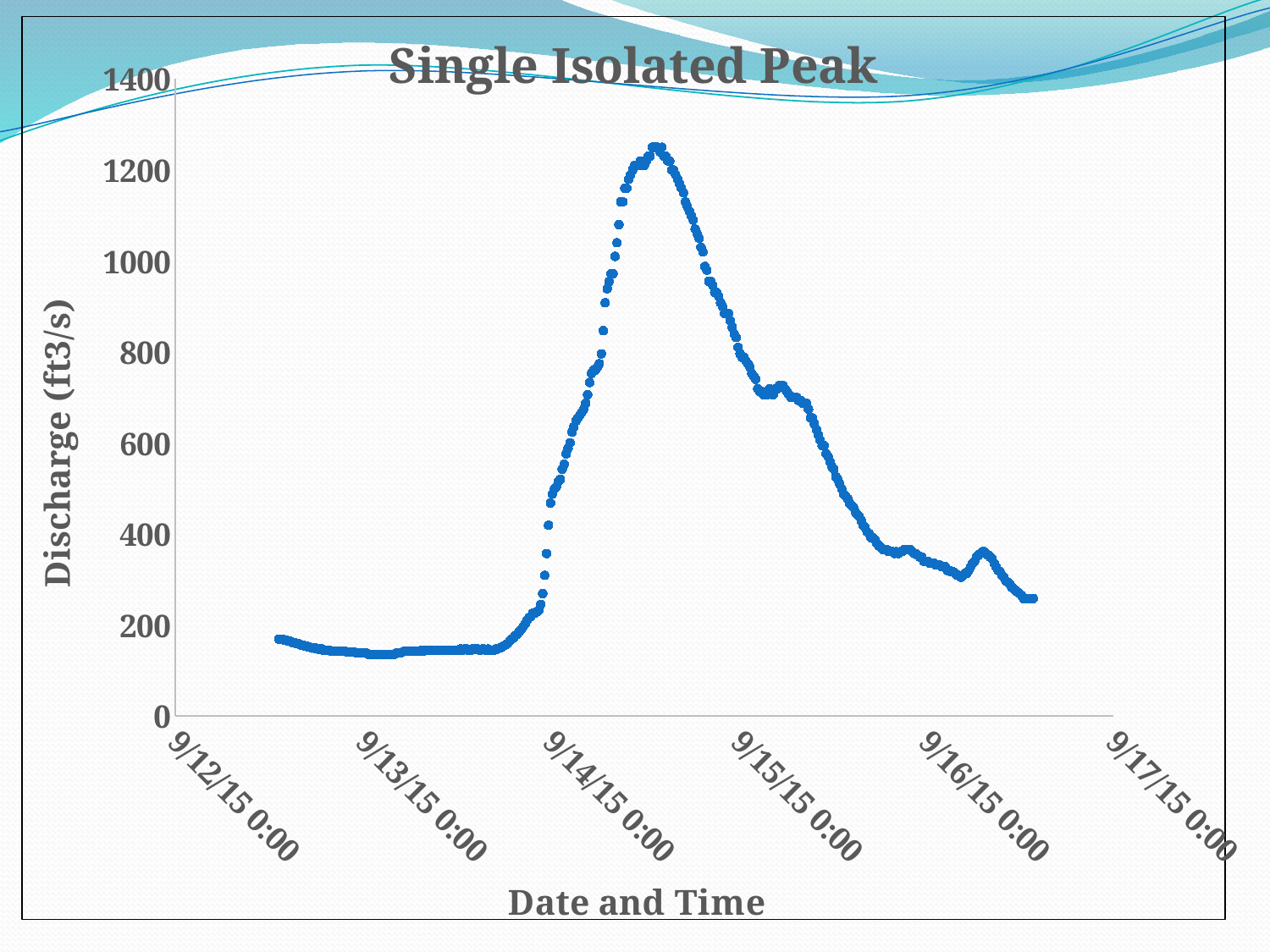
Does the discharge rise or fall between 9/15/15 0:00 and 9/16/15 0:00? fall Is the discharge at 9/13/15 0:00 greater or less than 200? less Between which two x-axis tick labels does the peak discharge occur? 9/14/15 0:00 and 9/15/15 0:00 Is the discharge at 9/16/15 0:00 greater or less than 400? less Does the discharge rise or fall between 9/13/15 0:00 and 9/14/15 0:00? rise How many date tick labels are shown on the x axis? 6 Is the peak discharge value greater or less than 1400? less What is the label of the vertical axis? Discharge (ft3/s) What kind of chart is shown on the slide? scatter chart What is the title of the chart? Single Isolated Peak